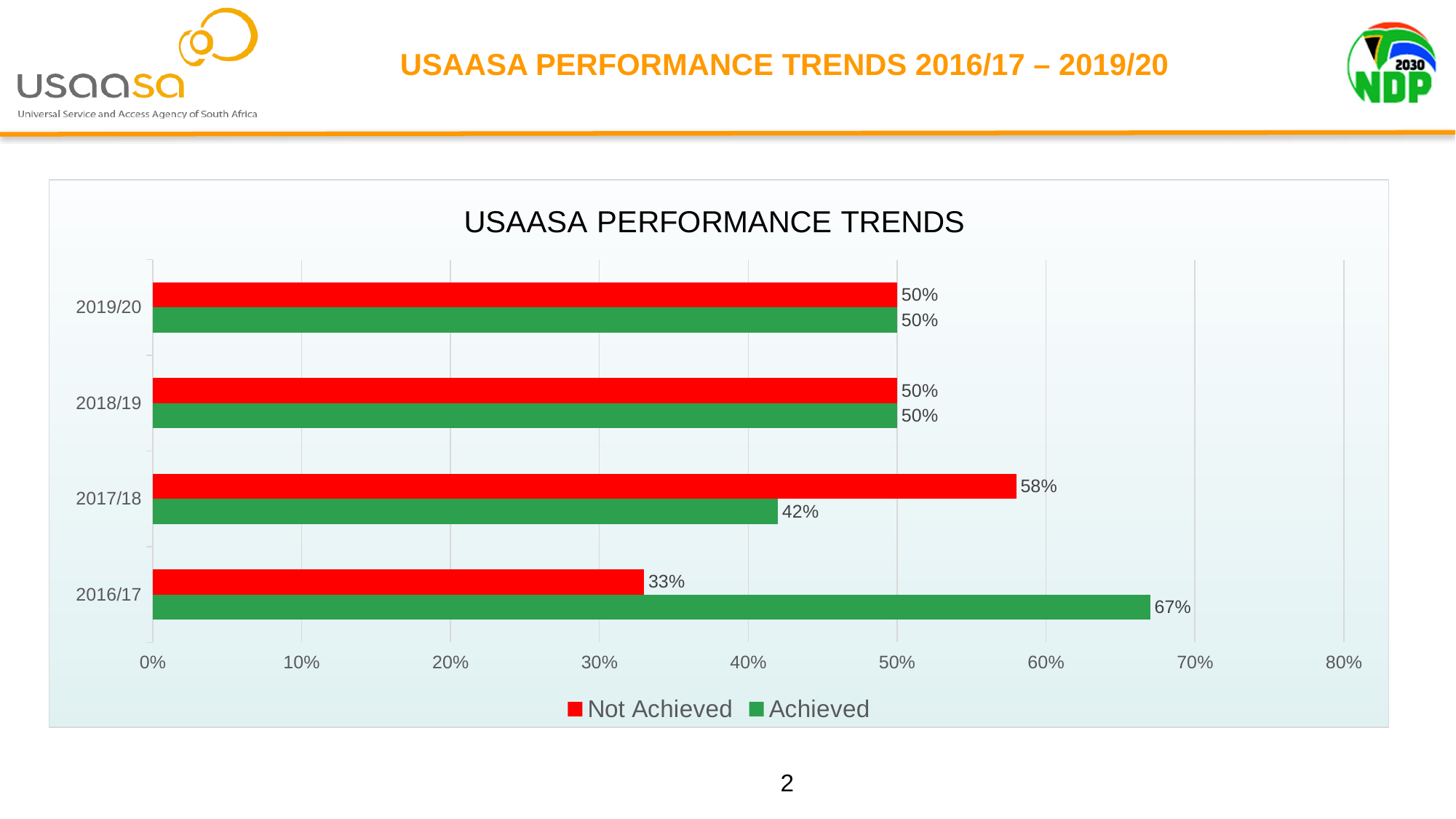
Which year has the highest Achieved value? 2016/17 Which year has the lowest Not Achieved value? 2016/17 How many series does the legend list? 2 How many years are shown on the chart? 4 What is the Not Achieved value for 2016/17? 33% What kind of chart is shown on the slide? Bar chart What is the difference between the Not Achieved and Achieved values for 2017/18? 16% What is the Achieved value for 2018/19? 50% What is the Achieved value for 2016/17? 67% What colour represents the Achieved series? Green Which is larger for 2016/17, the Achieved value or the Not Achieved value? Achieved What is the Not Achieved value for 2017/18? 58%